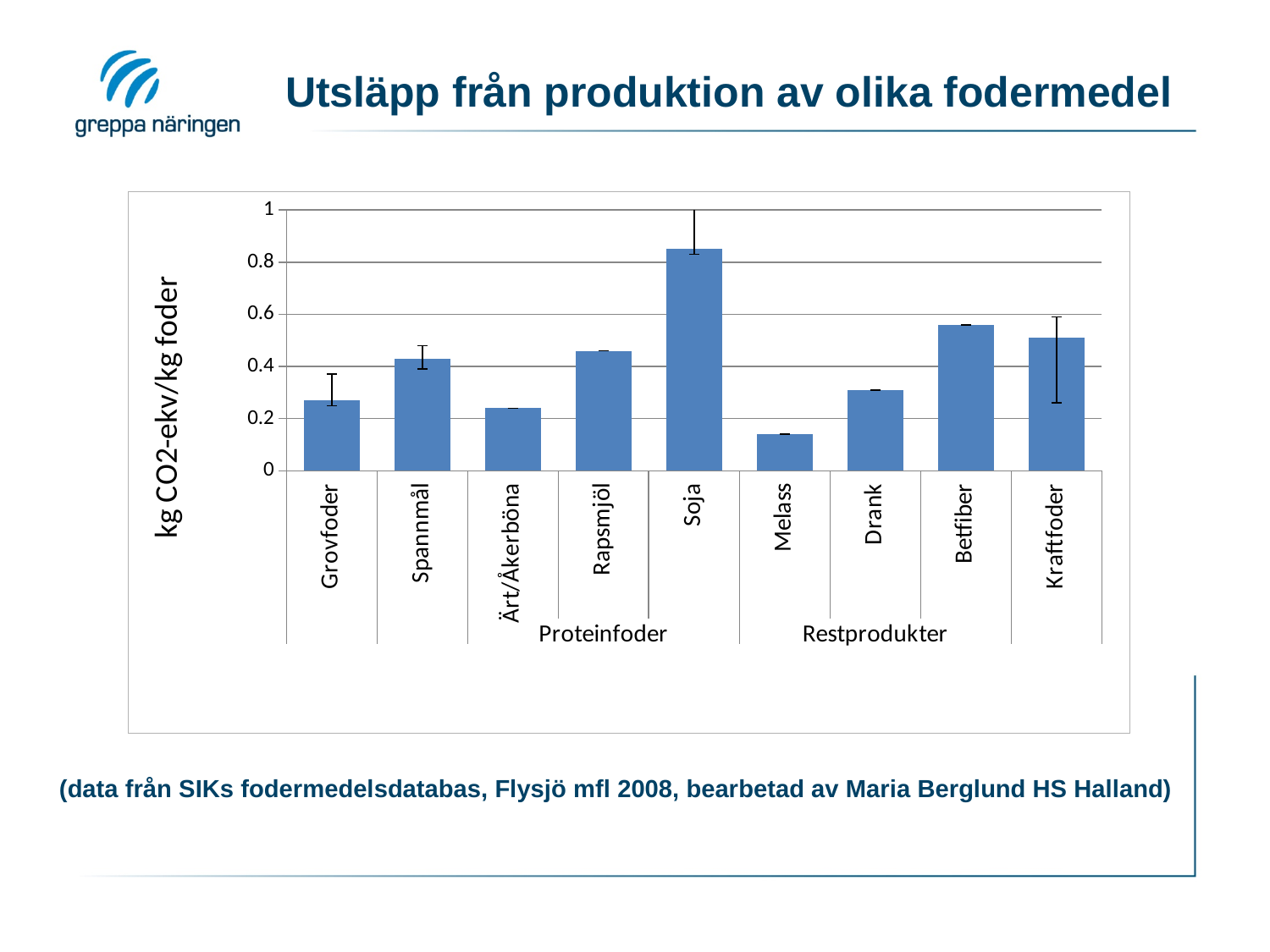
What is the label on the vertical axis of the chart? kg CO2-ekv/kg foder Is the value for Ärt/Åkerböna greater or less than 0.4? less Which has higher emissions, Drank or Betfiber? Betfiber Is the value for Melass greater or less than 0.2? less Which feed has the lowest emissions in the chart? Melass Which feed has the highest emissions in the chart? Soja Is the value for Betfiber greater or less than 0.4? greater What kind of chart is shown on the slide? Bar chart How many feed categories are plotted in the chart? 9 Which has higher emissions, Spannmål or Grovfoder? Spannmål What are the two group labels shown beneath the category names on the x axis? Proteinfoder and Restprodukter